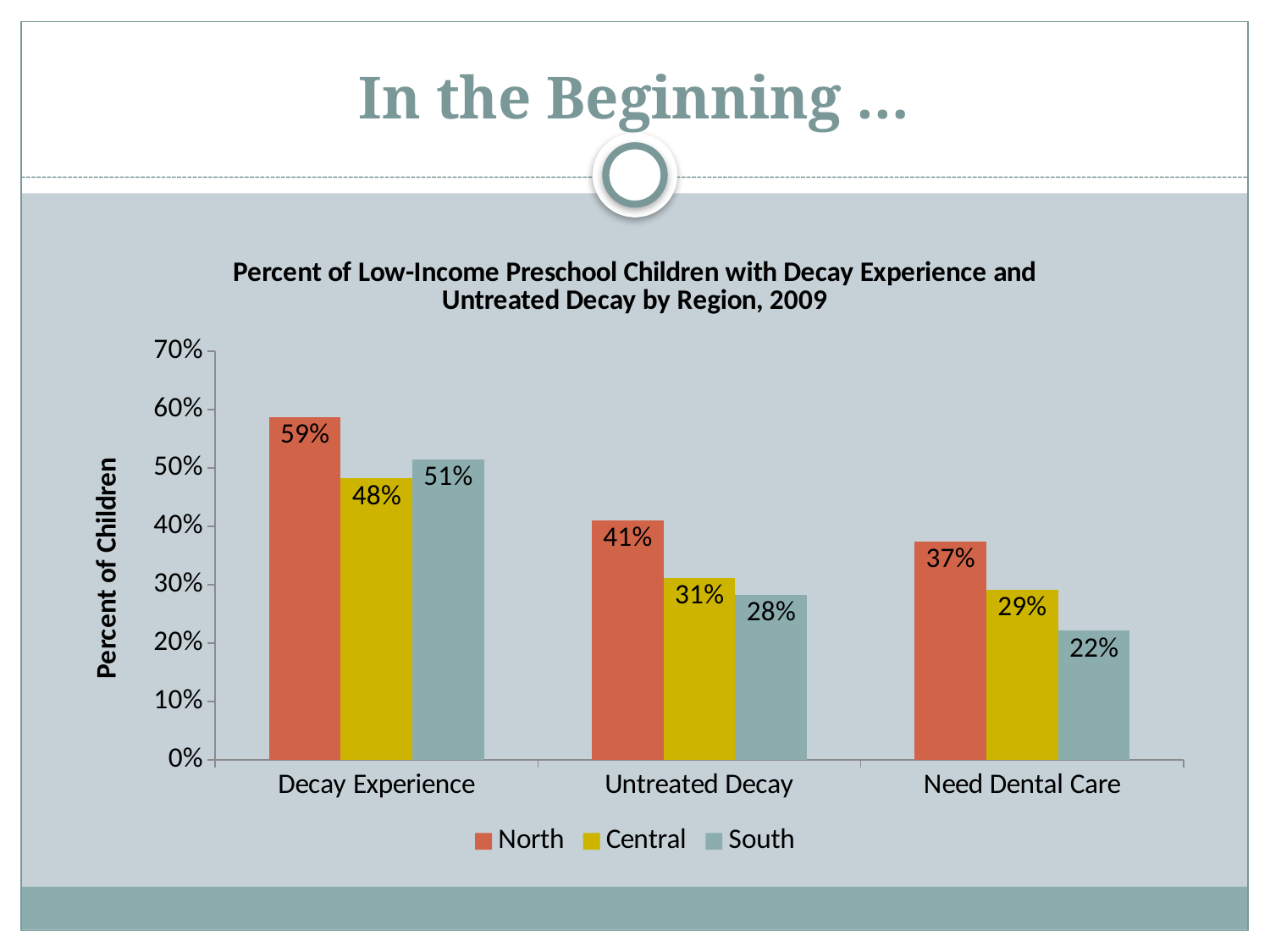
Which region has the lowest value in the Decay Experience category? Central What is the label of the y axis? Percent of Children What kind of chart is shown on the slide? Bar chart What is the value for North in the Decay Experience category? 59% How many series does the legend list? 3 Which is larger: the South value for Decay Experience or the Central value for Decay Experience? South How many categories are shown on the x axis? 3 What is the value for South in the Need Dental Care category? 22% Is the value for North in the Need Dental Care category greater or less than 40%? less What is the value for Central in the Untreated Decay category? 31% Which region has the highest value in the Untreated Decay category? North What is the difference between the North and South values in the Need Dental Care category? 15%